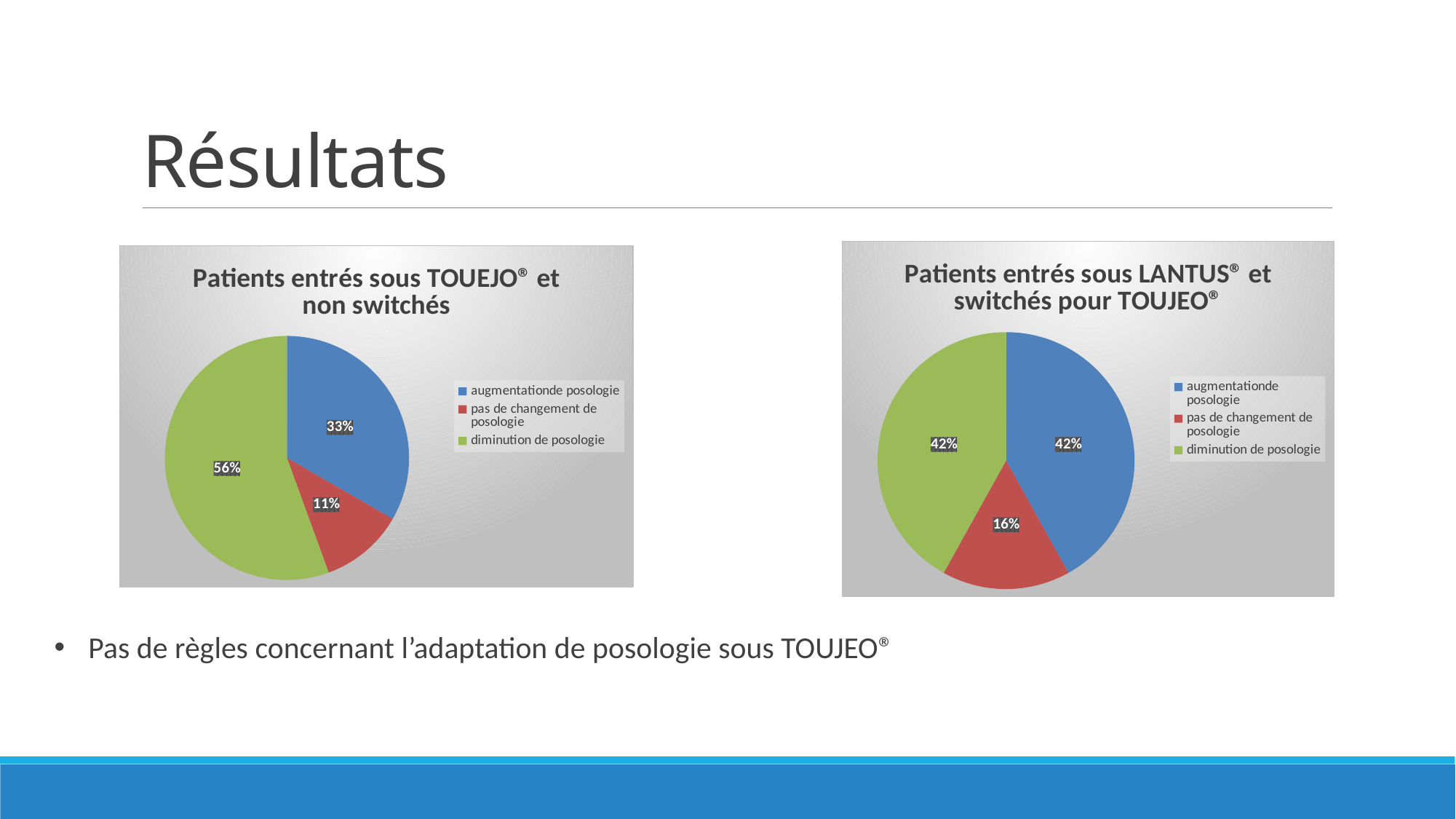
In the left chart (Patients entrés sous TOUEJO et non switchés), which category has the smallest slice? pas de changement de posologie In the left chart (Patients entrés sous TOUEJO et non switchés), what share is labelled for 'augmentation de posologie'? 33% In the left chart (Patients entrés sous TOUEJO et non switchés), what is the difference between the 'diminution de posologie' and 'augmentation de posologie' shares? 23% How many categories does the legend of the left chart (Patients entrés sous TOUEJO et non switchés) list? 3 In the right chart (Patients entrés sous LANTUS et switchés pour TOUJEO), what is the difference between the 'augmentation de posologie' and 'pas de changement de posologie' shares? 26% In the left chart (Patients entrés sous TOUEJO et non switchés), what share is labelled for 'diminution de posologie'? 56% In the left chart (Patients entrés sous TOUEJO et non switchés), what share is labelled for 'pas de changement de posologie'? 11% In the right chart (Patients entrés sous LANTUS et switchés pour TOUJEO), what share is labelled for 'augmentation de posologie'? 42% What kind of chart is the right chart (Patients entrés sous LANTUS et switchés pour TOUJEO)? pie chart In the right chart (Patients entrés sous LANTUS et switchés pour TOUJEO), what share is labelled for 'pas de changement de posologie'? 16% In the right chart (Patients entrés sous LANTUS et switchés pour TOUJEO), which category has the smallest slice? pas de changement de posologie In the left chart (Patients entrés sous TOUEJO et non switchés), which category has the largest slice? diminution de posologie